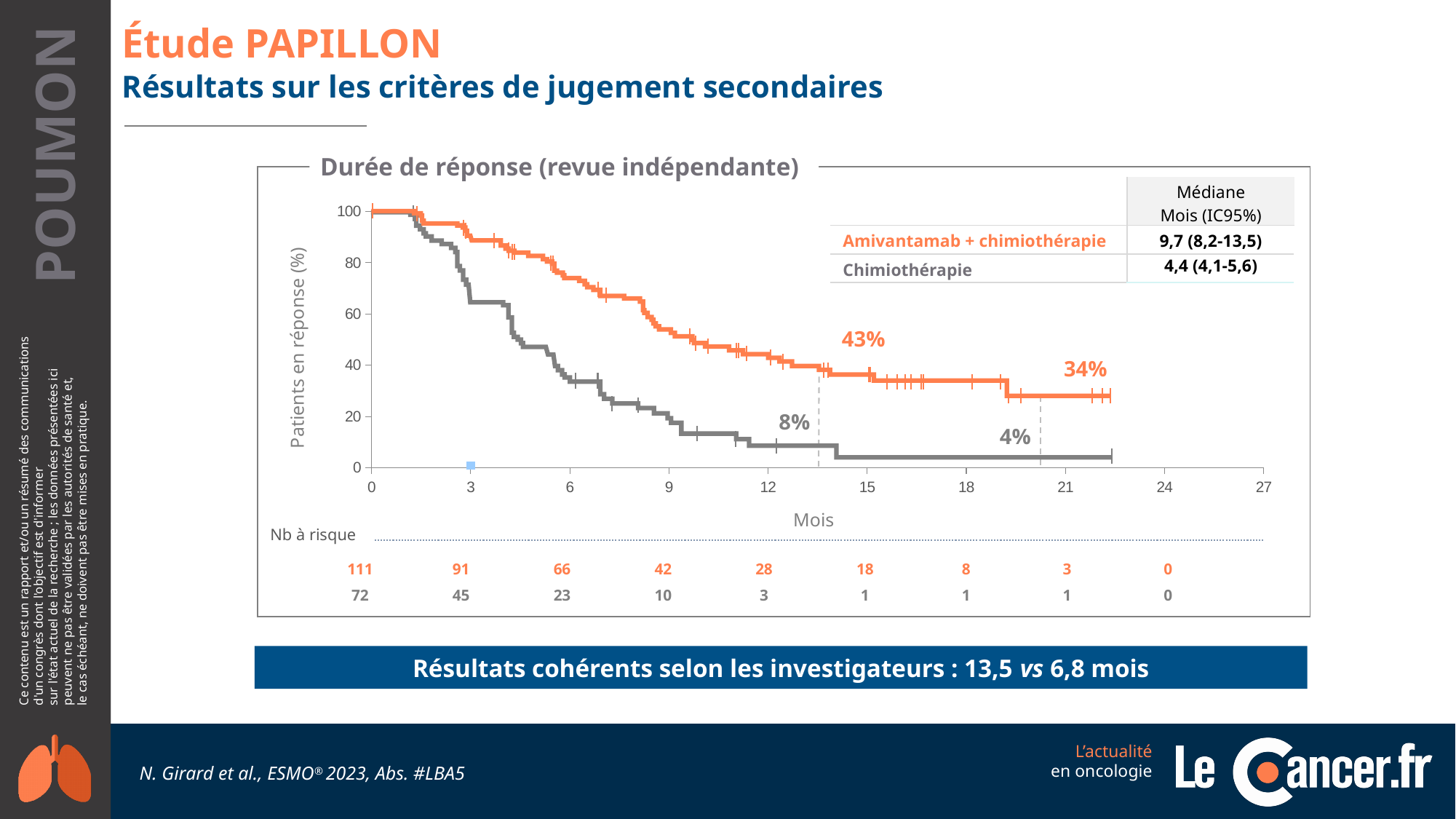
What percentage of patients are still in response on the Chimiothérapie curve at the second dashed landmark line? 4% What is the difference in percentage points between the two arms at the first dashed landmark line (43% vs 8%)? 35 percentage points What is the difference in the number of patients at risk between the two arms at 3 months (91 vs 45)? 46 What is the title of the chart? Durée de réponse (revue indépendante) What kind of chart is shown on the slide? Kaplan-Meier (line) curve Is the value of the Amivantamab + chimiothérapie curve at 9 months greater or less than 40? greater What percentage of patients are still in response on the Amivantamab + chimiothérapie curve at the first dashed landmark line? 43% What is the median duration of response (months, IC95%) for Amivantamab + chimiothérapie? 9,7 (8,2-13,5) How many treatment arms (series) are plotted on the chart? 2 What is the median duration of response (months, IC95%) for Chimiothérapie? 4,4 (4,1-5,6) How many patients are at risk in the Amivantamab + chimiothérapie arm at 0 months? 111 Which arm has the higher median duration of response? Amivantamab + chimiothérapie